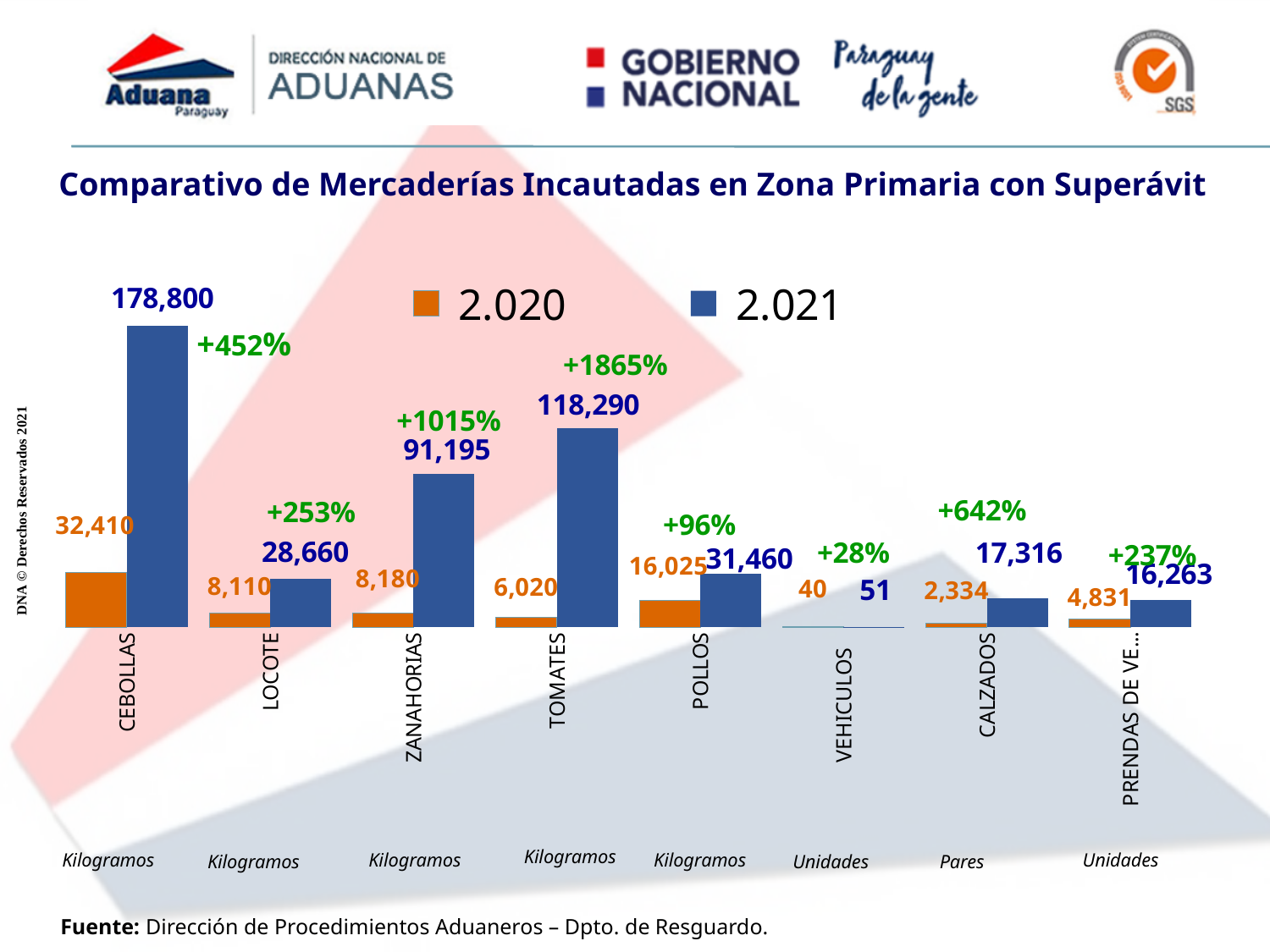
What is the 2.021 value for CEBOLLAS? 178,800 Which is larger: the 2.021 value for TOMATES or the 2.021 value for ZANAHORIAS? TOMATES What is the 2.020 value for VEHICULOS? 40 What is the difference between the 2.021 and 2.020 values for POLLOS? 15,435 What kind of chart is shown on the slide? Bar chart How many series does the legend list? 2 Which category has the lowest 2.020 value? VEHICULOS What is the 2.020 value for TOMATES? 6,020 Which category has the highest 2.021 value? CEBOLLAS How many categories are shown on the x axis? 8 What percentage increase is shown above the CALZADOS bars? +642% What is the 2.021 value for ZANAHORIAS? 91,195